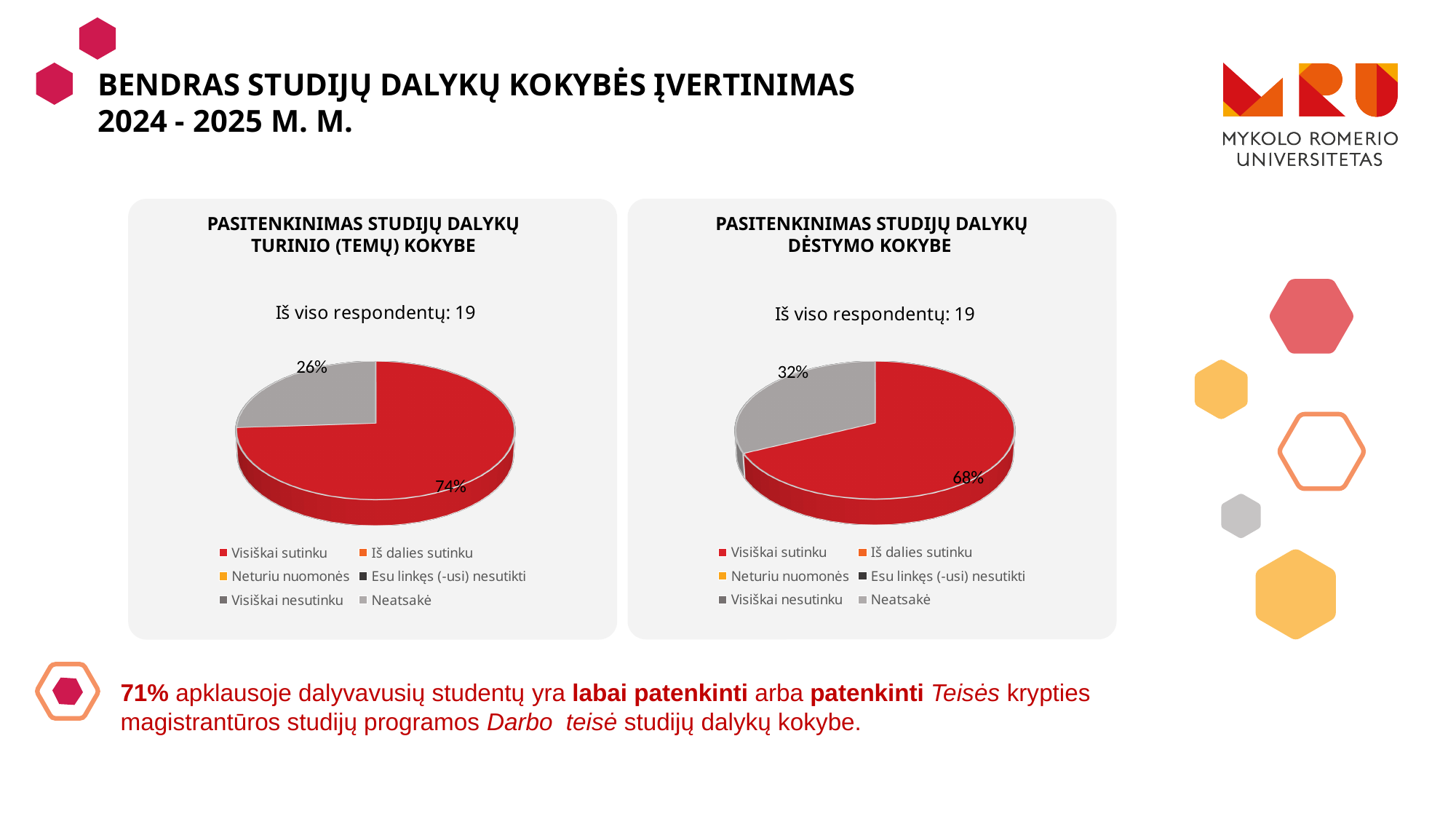
What type of chart is used on this slide? Pie chart How many entries does the legend of the left chart list? 6 In the right chart, what is the difference between the red slice and the grey slice? 36 percentage points In the left chart (Pasitenkinimas studijų dalykų turinio (temų) kokybe), what percentage is shown for the grey slice? 26% What is the title of the left chart? Pasitenkinimas studijų dalykų turinio (temų) kokybe In the left chart, which slice is the largest? Visiškai sutinku (74%) How many respondents are reported for the right chart? 19 In the left chart (Pasitenkinimas studijų dalykų turinio (temų) kokybe), what percentage is shown for the red slice (Visiškai sutinku)? 74% How many slices are visible in the right chart? 2 In the right chart (Pasitenkinimas studijų dalykų dėstymo kokybe), what percentage is shown for the red slice (Visiškai sutinku)? 68% In the right chart (Pasitenkinimas studijų dalykų dėstymo kokybe), what percentage is shown for the grey slice? 32% Is the Visiškai sutinku share larger in the left chart or in the right chart? Left chart (74% vs 68%)